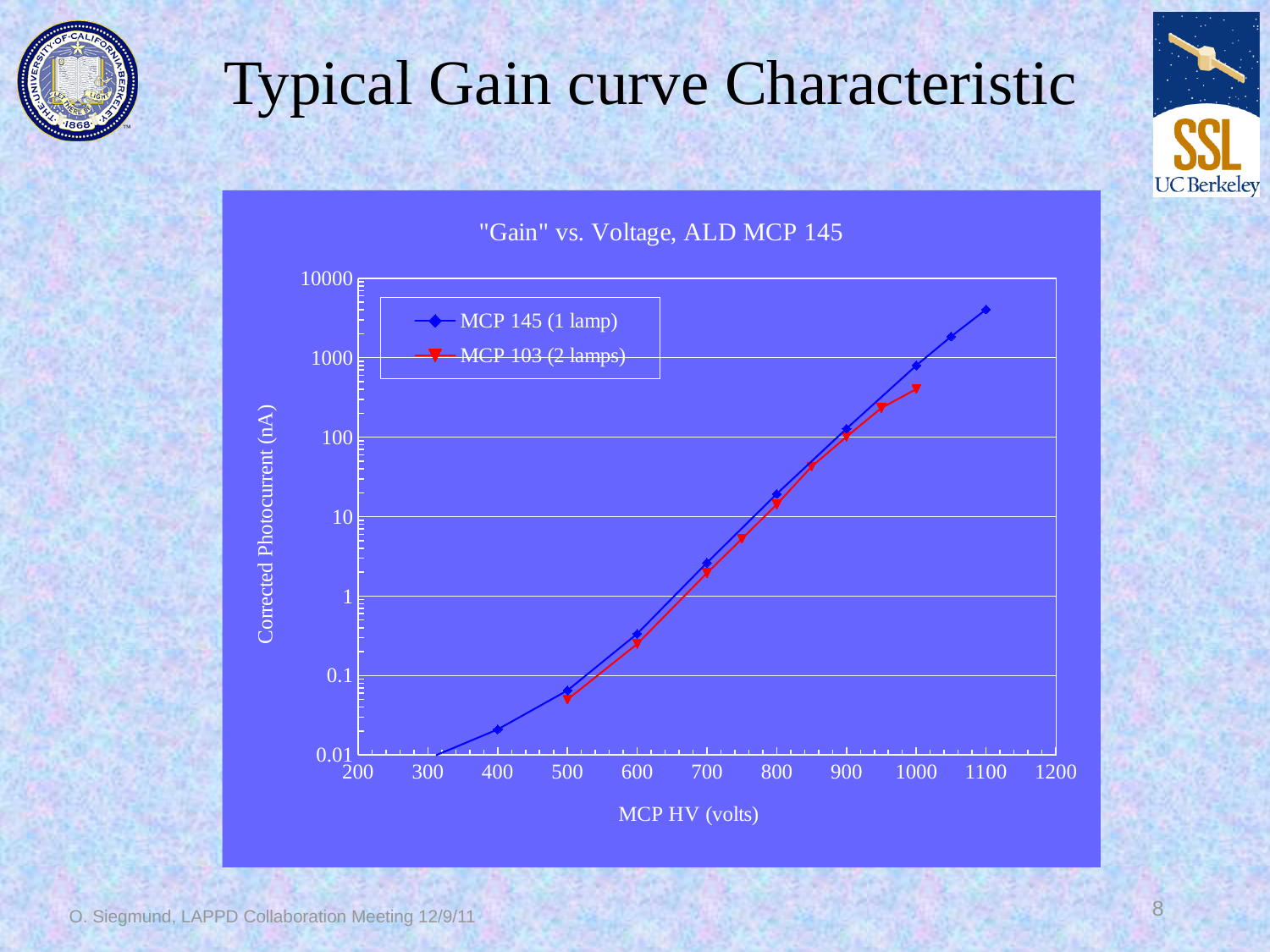
At 1000 volts, which series has the larger value, MCP 145 (1 lamp) or MCP 103 (2 lamps)? MCP 145 (1 lamp) Is the value for MCP 103 (2 lamps) at 1000 volts greater or less than 1000? less What is the title of the chart? "Gain" vs. Voltage, ALD MCP 145 Do the values for MCP 145 (1 lamp) rise or fall as MCP HV increases? rise What kind of chart is shown on the slide? line chart Is the value for MCP 145 (1 lamp) at 900 volts greater or less than 100? greater What is the label of the y axis? Corrected Photocurrent (nA) Is the value for MCP 145 (1 lamp) at 400 volts greater or less than 0.1? less How many series does the legend list? 2